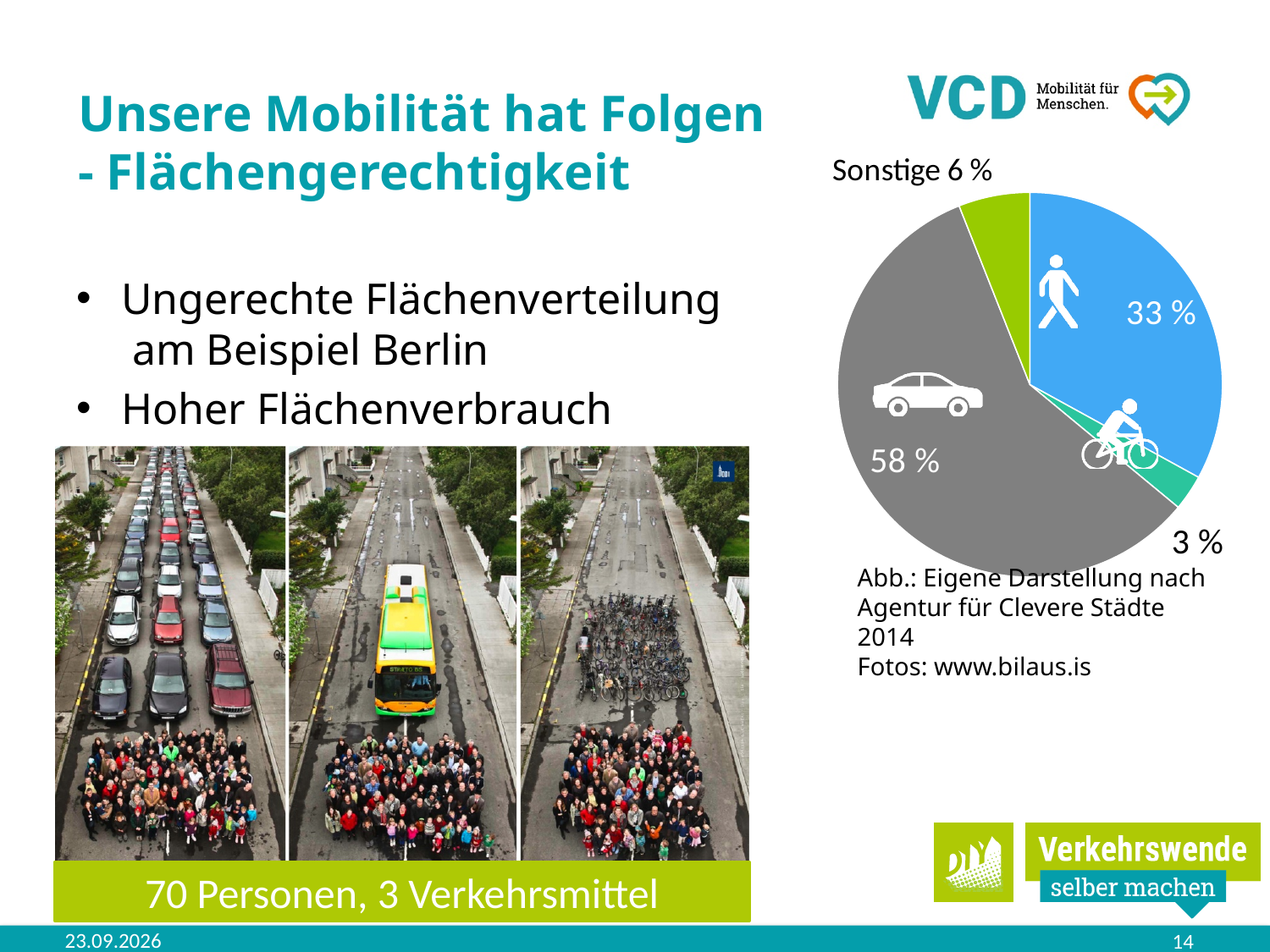
In the pie chart, what share is shown for the slice with the car icon? 58 % Which is larger in the pie chart: the pedestrian slice or the 'Sonstige' slice? the pedestrian slice In the pie chart, what share is shown for the slice with the pedestrian icon? 33 % What is the difference in percentage points between the car slice and the pedestrian slice? 25 percentage points What colour is the car slice in the pie chart? grey In the pie chart, what share is shown for the slice with the bicycle icon? 3 % What kind of chart is shown on the right side of the slide? pie chart Which slice of the pie chart is the smallest? the bicycle slice (3 %) What colour is the pedestrian slice in the pie chart? blue How many slices does the pie chart have? 4 Which slice of the pie chart is the largest? the car slice (58 %) In the pie chart, what share is shown for 'Sonstige'? 6 %